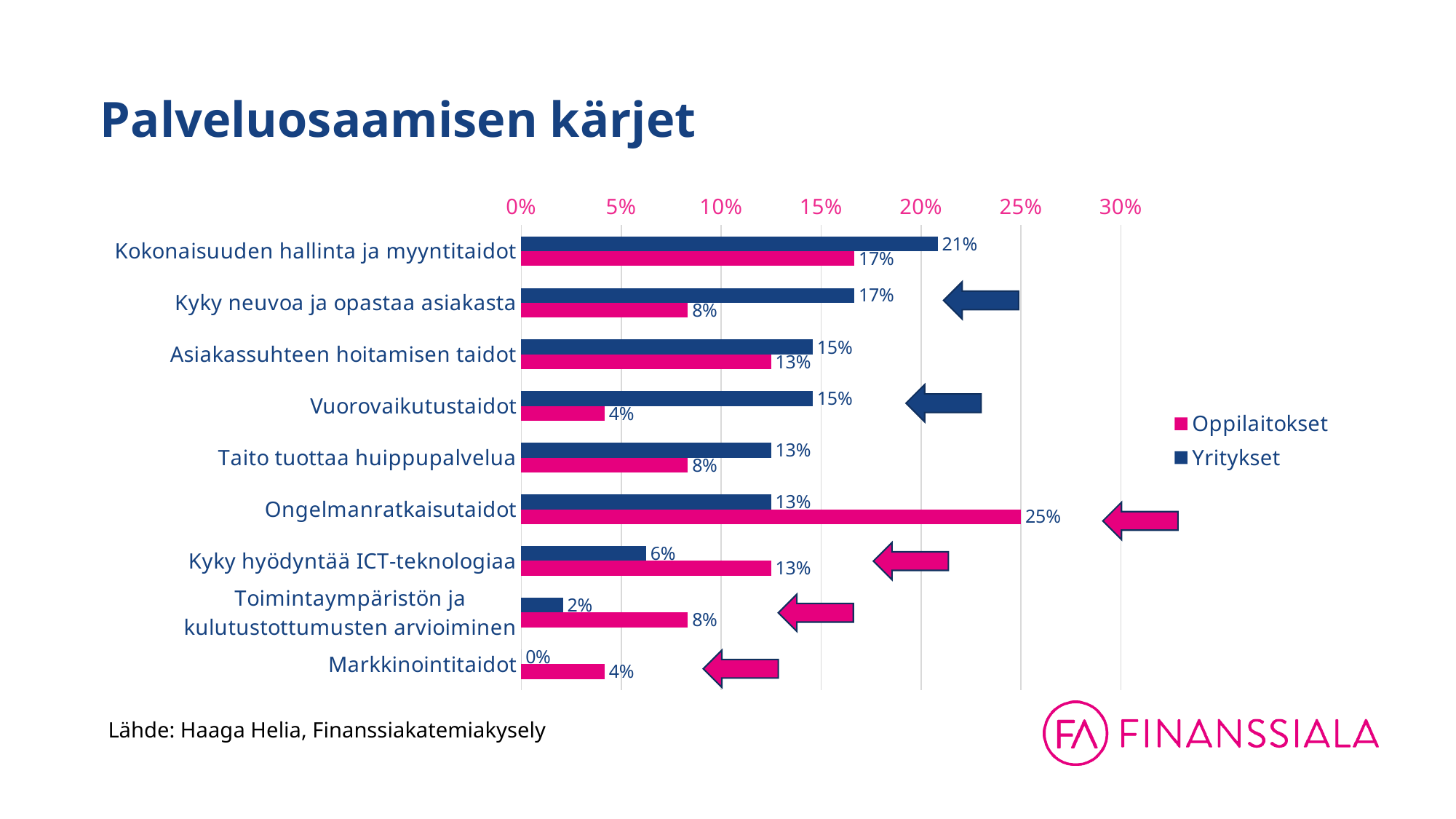
What is the Oppilaitokset value for Vuorovaikutustaidot? 4% For Kyky hyödyntää ICT-teknologiaa, which series has the larger value, Oppilaitokset or Yritykset? Oppilaitokset What kind of chart is shown on the slide? Bar chart What is the Yritykset value for Kokonaisuuden hallinta ja myyntitaidot? 21% Which category has the highest Oppilaitokset value? Ongelmanratkaisutaidot Which category has the highest Yritykset value? Kokonaisuuden hallinta ja myyntitaidot How many series does the legend list? 2 Which category has the lowest Yritykset value? Markkinointitaidot What is the Oppilaitokset value for Ongelmanratkaisutaidot? 25% How many categories are shown on the chart? 9 What is the difference between the Yritykset and Oppilaitokset values for Kyky neuvoa ja opastaa asiakasta? 9% What is the Yritykset value for Markkinointitaidot? 0%